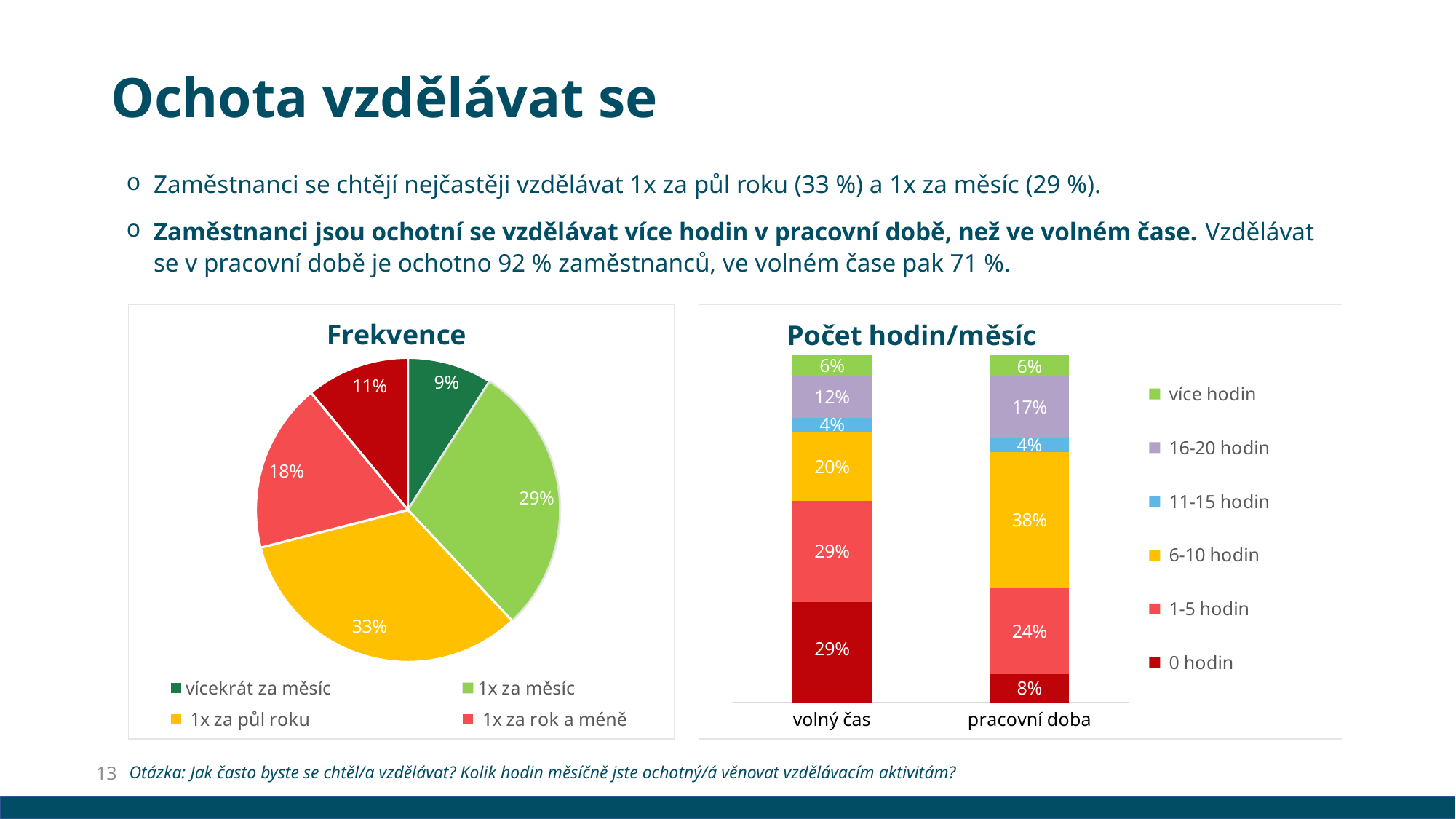
In the "Frekvence" chart, what is the value for "1x za rok a méně"? 18% In the "Počet hodin/měsíc" chart, which category has the larger value for "16-20 hodin", "volný čas" or "pracovní doba"? pracovní doba How many entries does the legend of the "Frekvence" chart list? 4 In the "Počet hodin/měsíc" chart, what is the difference between the "6-10 hodin" values for "pracovní doba" and "volný čas"? 18% In the "Frekvence" chart, what share of the pie is "1x za půl roku"? 33% How many series does the legend of the "Počet hodin/měsíc" chart list? 6 In the "Frekvence" chart, which category has the largest slice? 1x za půl roku In the "Počet hodin/měsíc" chart, what is the value for "0 hodin" in "volný čas"? 29% In the "Počet hodin/měsíc" chart, what is the value for "6-10 hodin" in "pracovní doba"? 38% What kind of chart is the "Počet hodin/měsíc" chart? stacked bar chart In the "Frekvence" chart, which category has the smallest slice? vícekrát za měsíc What kind of chart is the "Frekvence" chart? pie chart